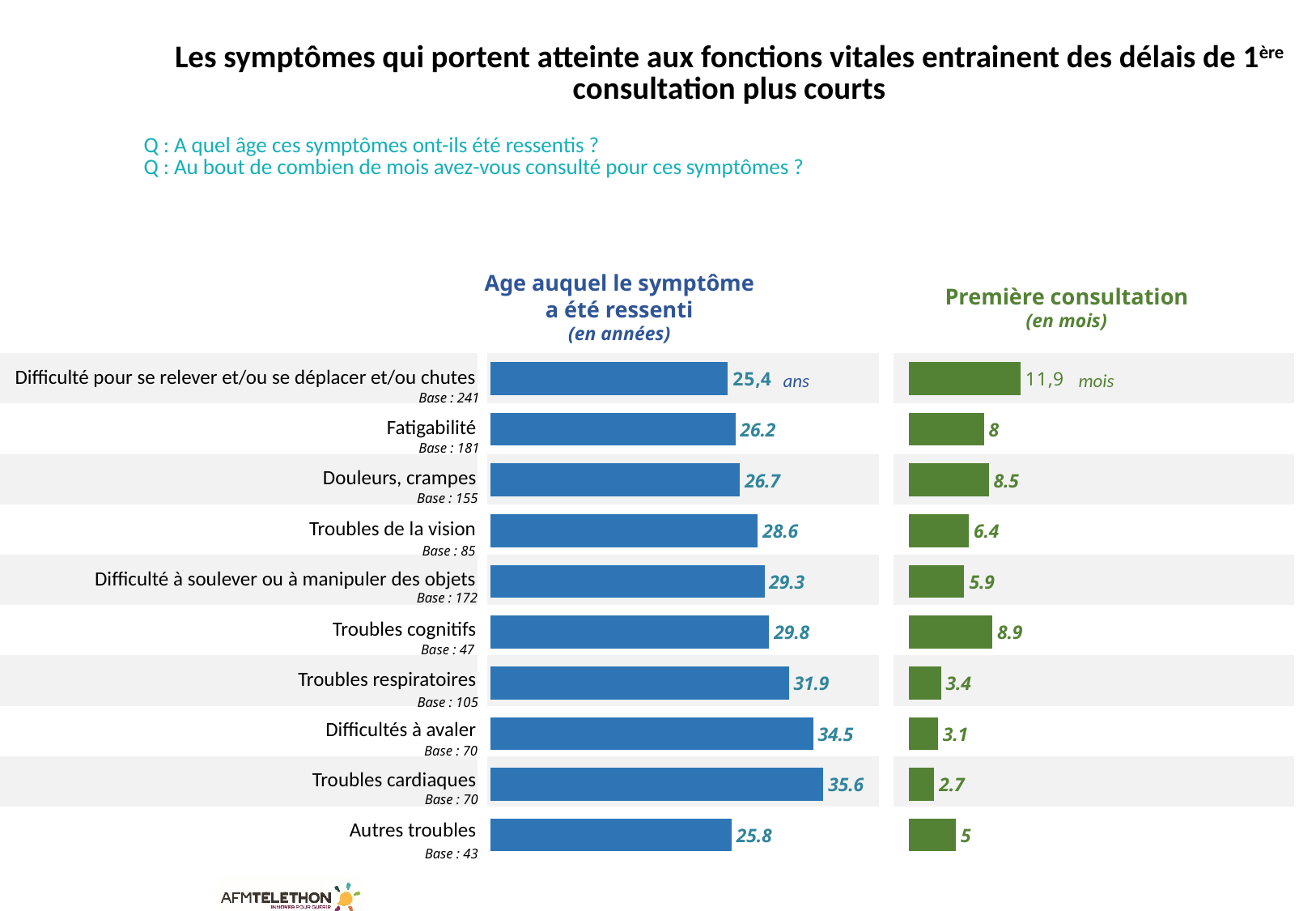
What kind of chart is the 'Première consultation' chart? Bar chart How many categories are shown in the 'Age auquel le symptôme a été ressenti' chart? 10 In the 'Première consultation' chart, what is the value for Troubles respiratoires? 3.4 In the 'Première consultation' chart, what is the difference between Douleurs, crampes and Fatigabilité? 0.5 In the 'Première consultation' chart, which category has the lowest value? Troubles cardiaques In the 'Age auquel le symptôme a été ressenti' chart, which category has the highest value? Troubles cardiaques In the 'Age auquel le symptôme a été ressenti' chart, what is the value for Troubles cardiaques? 35.6 In the 'Première consultation' chart, which category has the highest value? Difficulté pour se relever et/ou se déplacer et/ou chutes In the 'Première consultation' chart, what is the value for Difficulté pour se relever et/ou se déplacer et/ou chutes? 11,9 In the 'Première consultation' chart, which is larger: Troubles cognitifs or Autres troubles? Troubles cognitifs In the 'Age auquel le symptôme a été ressenti' chart, which is larger: Difficultés à avaler or Troubles de la vision? Difficultés à avaler In the 'Age auquel le symptôme a été ressenti' chart, what is the difference between Troubles cardiaques and Difficulté pour se relever et/ou se déplacer et/ou chutes? 10.2